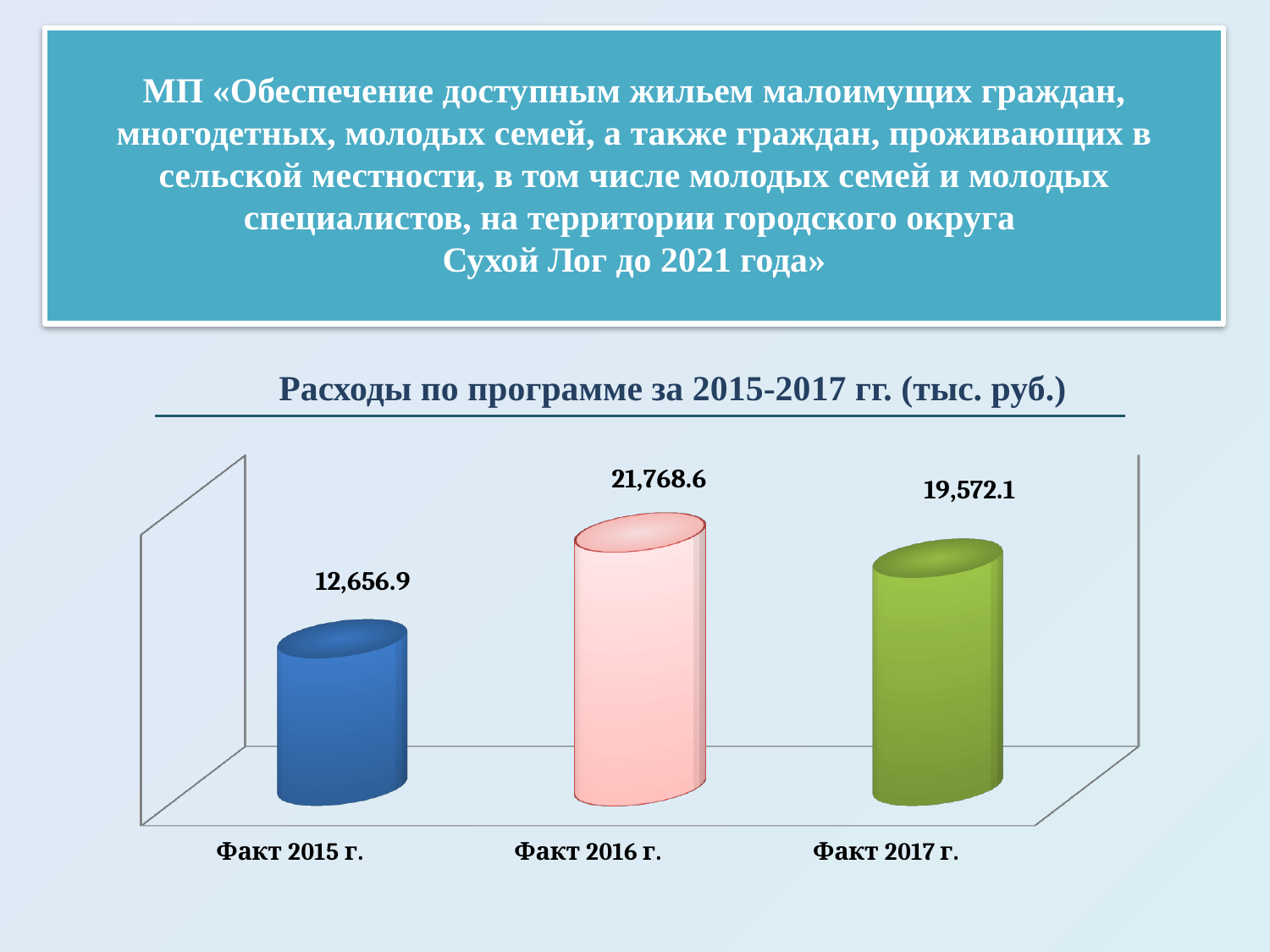
What is the title of the chart? Расходы по программе за 2015-2017 гг. (тыс. руб.) What kind of chart is this? bar chart What is the value for Факт 2017 г.? 19,572.1 What is the difference between the values for Факт 2016 г. and Факт 2017 г.? 2,196.5 Which category has the highest value? Факт 2016 г. What is the value for Факт 2015 г.? 12,656.9 Which is larger, the value for Факт 2017 г. or Факт 2015 г.? Факт 2017 г. Which category has the lowest value? Факт 2015 г. Does the value rise or fall from Факт 2016 г. to Факт 2017 г.? fall What is the value for Факт 2016 г.? 21,768.6 What is the difference between the values for Факт 2016 г. and Факт 2015 г.? 9,111.7 How many categories are shown on the chart? 3